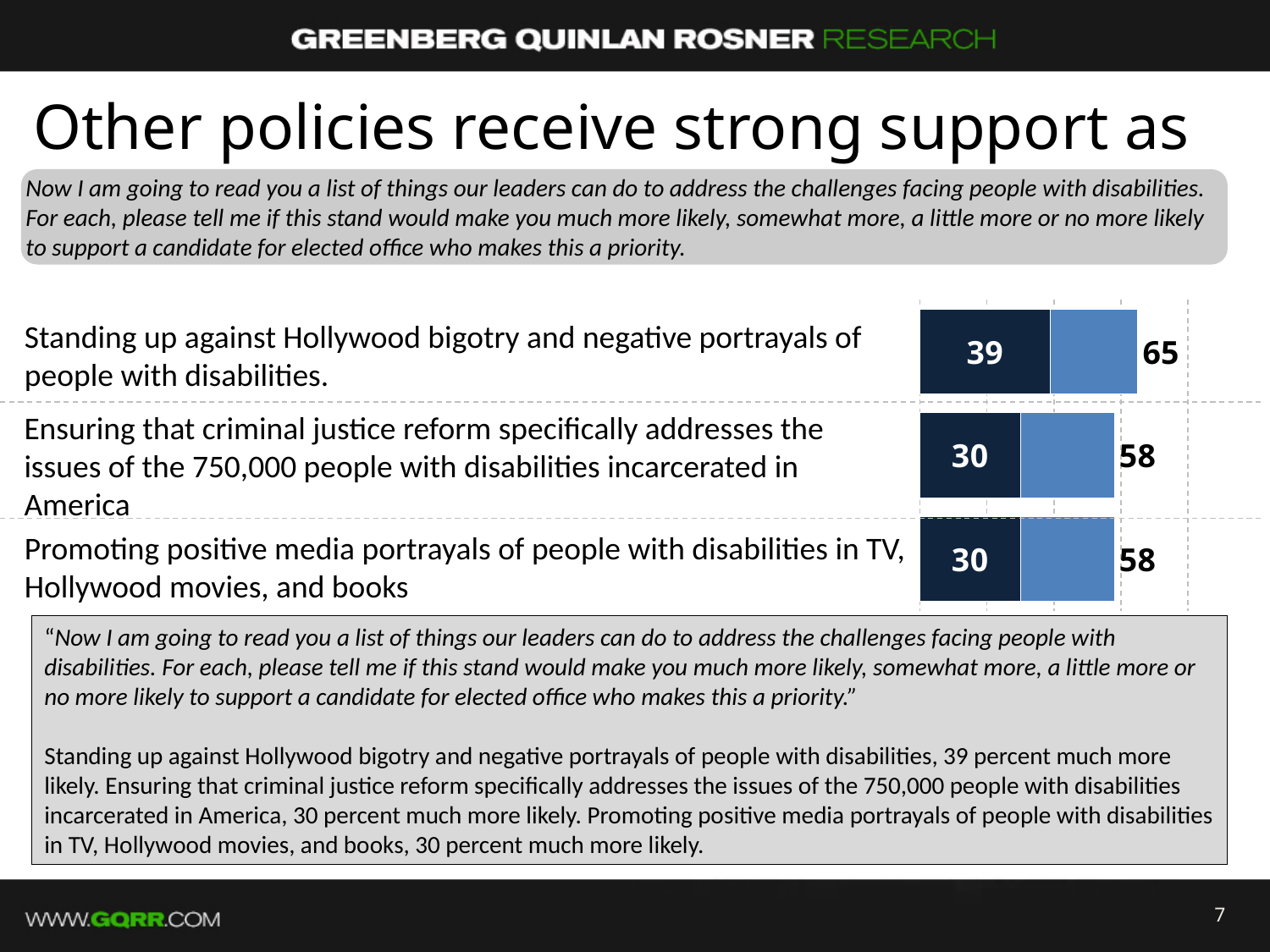
What is the difference between the total for "Standing up against Hollywood bigotry" (65) and the total for "Promoting positive media portrayals" (58)? 7 What is the difference between the dark-segment value for "Standing up against Hollywood bigotry" (39) and the dark-segment value for "Ensuring that criminal justice reform" (30)? 9 What value is printed on the dark segment of the bar for "Standing up against Hollywood bigotry and negative portrayals of people with disabilities"? 39 What colour is the segment of each bar that carries the printed values 39, 30 and 30? Dark navy What kind of chart is shown on the slide? Stacked bar chart How many coloured segments make up each bar in the chart? 2 What total value is printed at the end of the bar for "Ensuring that criminal justice reform specifically addresses the issues of the 750,000 people with disabilities incarcerated in America"? 58 Which policy has the highest total value in the chart? Standing up against Hollywood bigotry and negative portrayals of people with disabilities What value is printed on the dark segment of the bar for "Promoting positive media portrayals of people with disabilities in TV, Hollywood movies, and books"? 30 What total value is printed at the end of the bar for "Standing up against Hollywood bigotry and negative portrayals of people with disabilities"? 65 How many policies (bars) are shown in the chart? 3 Which has the larger dark-segment value: "Standing up against Hollywood bigotry" or "Ensuring that criminal justice reform"? Standing up against Hollywood bigotry